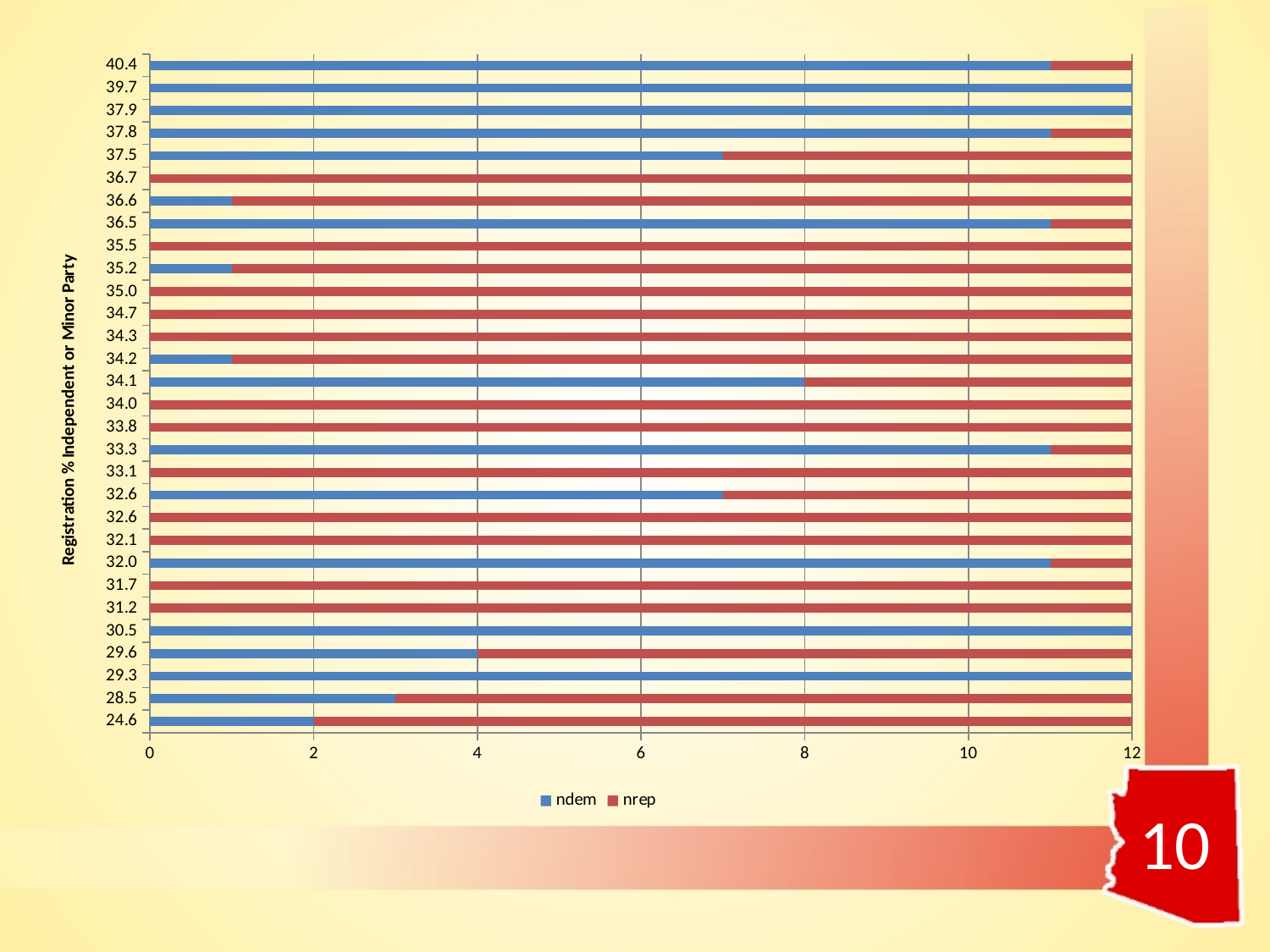
What is the ndem value for the 34.1 category? 8 What is the ndem value for the 29.6 category? 4 What kind of chart is shown on the slide? bar chart What is the ndem value for the 24.6 category? 2 What is the title of the vertical axis? Registration % Independent or Minor Party For the 34.1 category, which series has the larger value, ndem or nrep? ndem How many series does the legend list? 2 Is the ndem value for the 40.4 category greater or less than 10? greater How many categories are plotted on the vertical axis? 30 What is the nrep value for the 36.7 category? 12 What is the total of the stacked bar for the 30.5 category? 12 Is the ndem value for the 36.6 category greater or less than 2? less